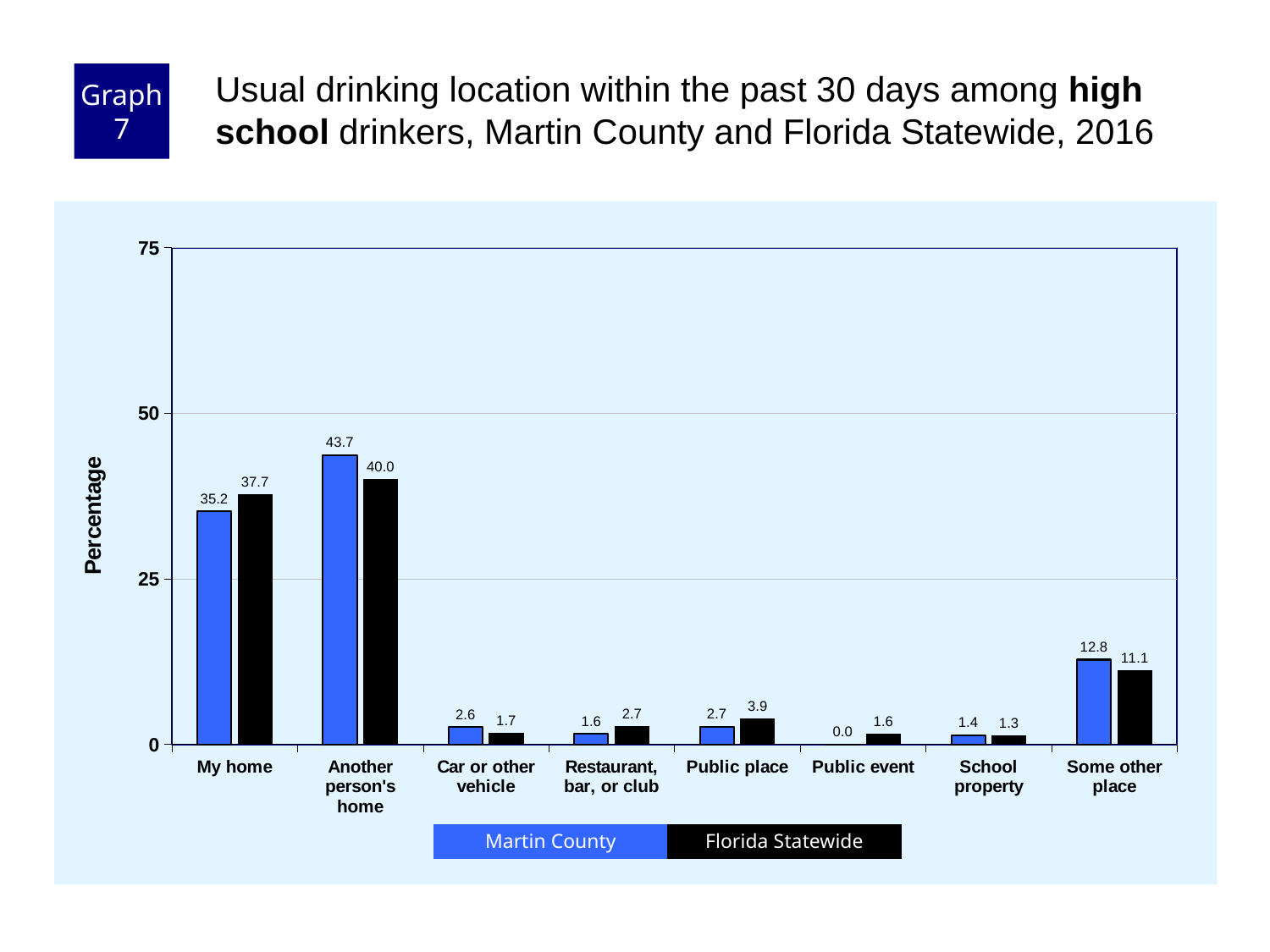
How many series does the legend list? 2 Is the Martin County value for "My home" greater or less than 25? greater What is the Florida Statewide value for "My home"? 37.7 Which category has the highest Martin County value? Another person's home How many location categories are shown on the x axis? 8 Which category has the lowest Florida Statewide value? School property What kind of chart is shown on the slide? Bar chart What is the difference between the Martin County and Florida Statewide values for "Another person's home"? 3.7 What is the Martin County value for "Public event"? 0.0 What is the Martin County value for "Another person's home"? 43.7 What is the label of the y axis? Percentage Which is larger for "Public place": Martin County or Florida Statewide? Florida Statewide